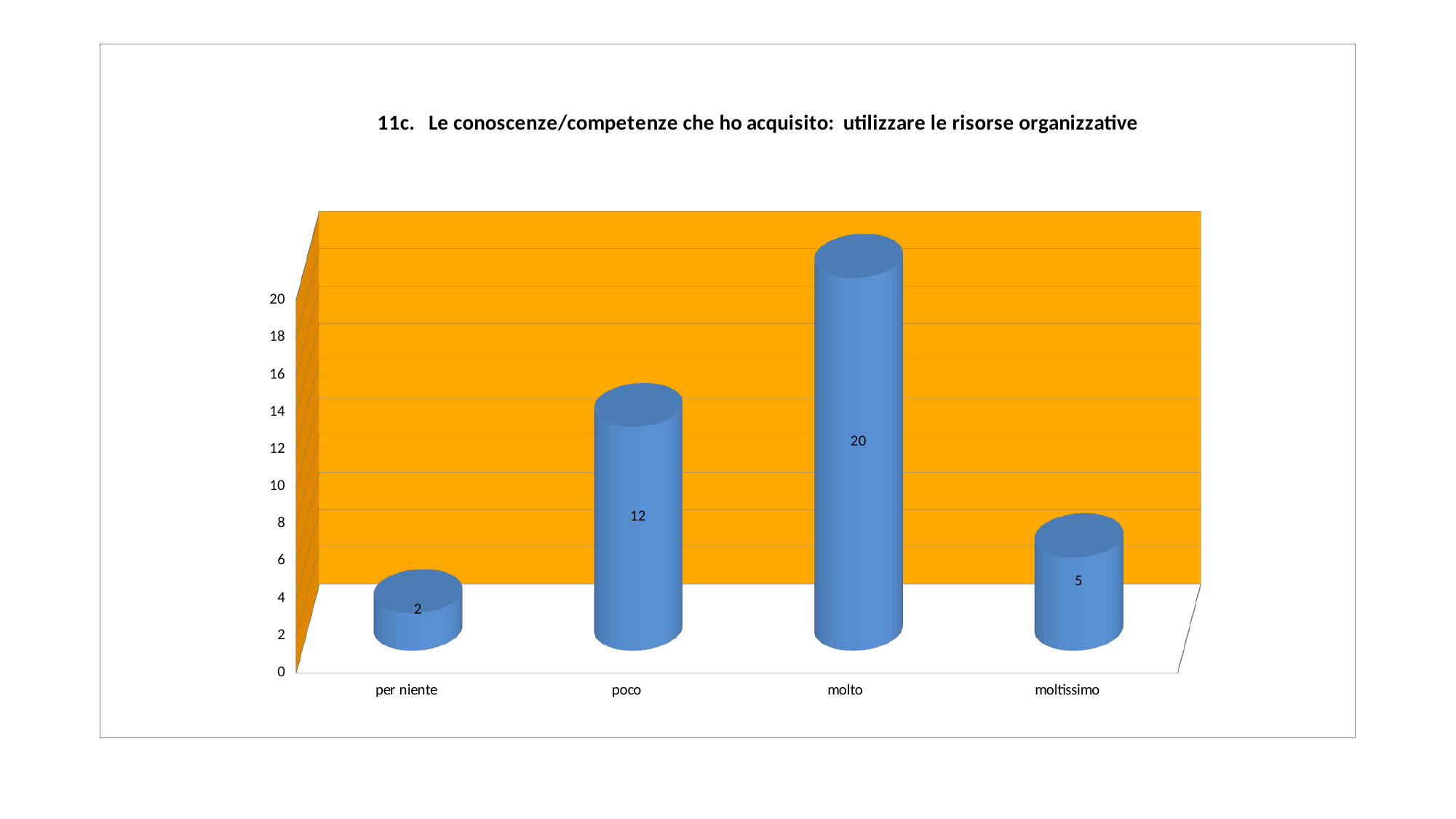
How many categories are shown on the x axis? 4 What is the value for "per niente"? 2 What kind of chart is this? bar chart Which category has the lowest value? per niente What is the title of the chart? 11c. Le conoscenze/competenze che ho acquisito: utilizzare le risorse organizzative What is the value for "moltissimo"? 5 What is the value for "poco"? 12 What is the difference between the values for "moltissimo" and "per niente"? 3 What is the difference between the values for "molto" and "poco"? 8 What is the value for "molto"? 20 Which is larger, the value for "poco" or the value for "moltissimo"? poco Which category has the highest value? molto